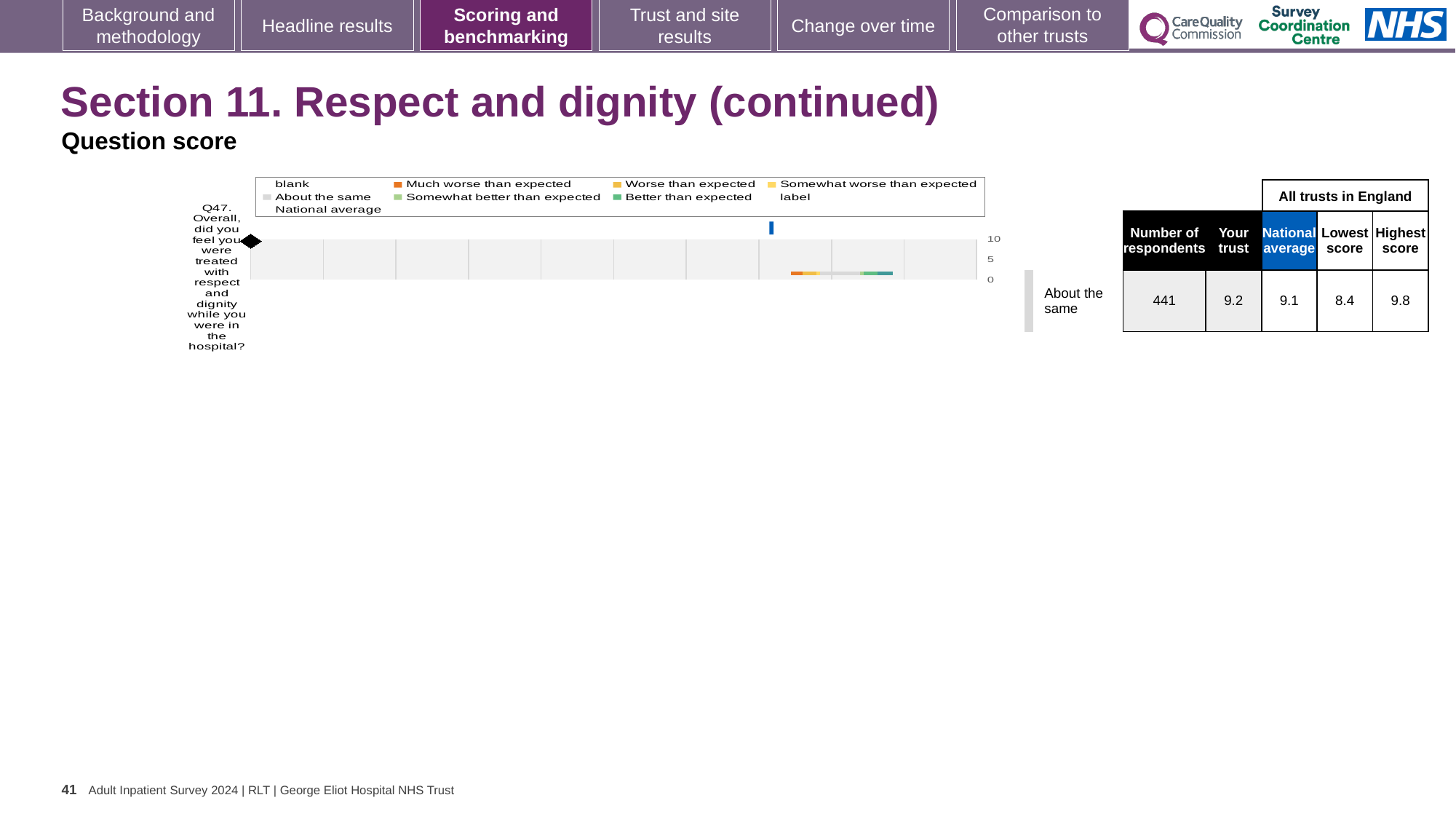
Which is larger for Q47: the 'Your trust' score or the national average? Your trust What is the lowest score among all trusts in England for Q47? 8.4 Which question number is plotted on the chart? Q47 What is the difference between the highest and lowest scores for Q47 across all trusts in England? 1.4 What is the 'Your trust' score for Q47 in the table next to the chart? 9.2 How many survey questions are plotted on the chart? 1 What is the highest score among all trusts in England for Q47? 9.8 What is the national average score for Q47 shown in the table? 9.1 What benchmarking category is the trust's Q47 result placed in? About the same How many respondents answered Q47? 441 What kind of chart is shown on the slide? bar chart What is the highest value shown on the chart's score axis? 10